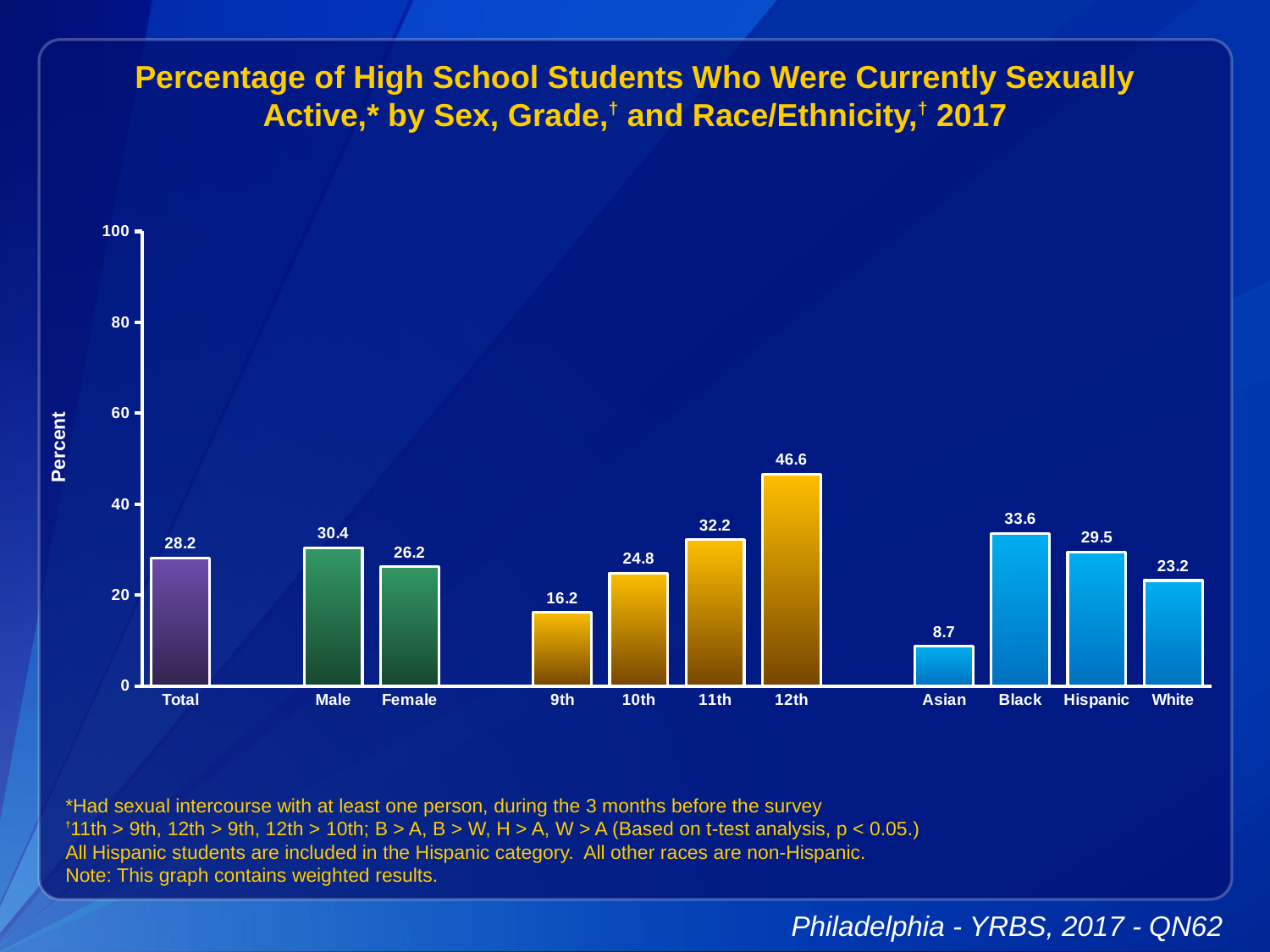
Which is larger, the value for Black or the value for Hispanic? Black What kind of chart is this? bar chart Which category has the lowest value? Asian What is the value for Asian students? 8.7 Is the value for 11th grade greater or less than 40? less What is the label of the y axis? Percent Which category has the highest value? 12th What is the difference between the values for Male and Female? 4.2 Do the values rise or fall from 9th grade to 12th grade? rise What is the value for Total? 28.2 How many categories are shown on the x axis? 11 What is the value for 12th grade students? 46.6